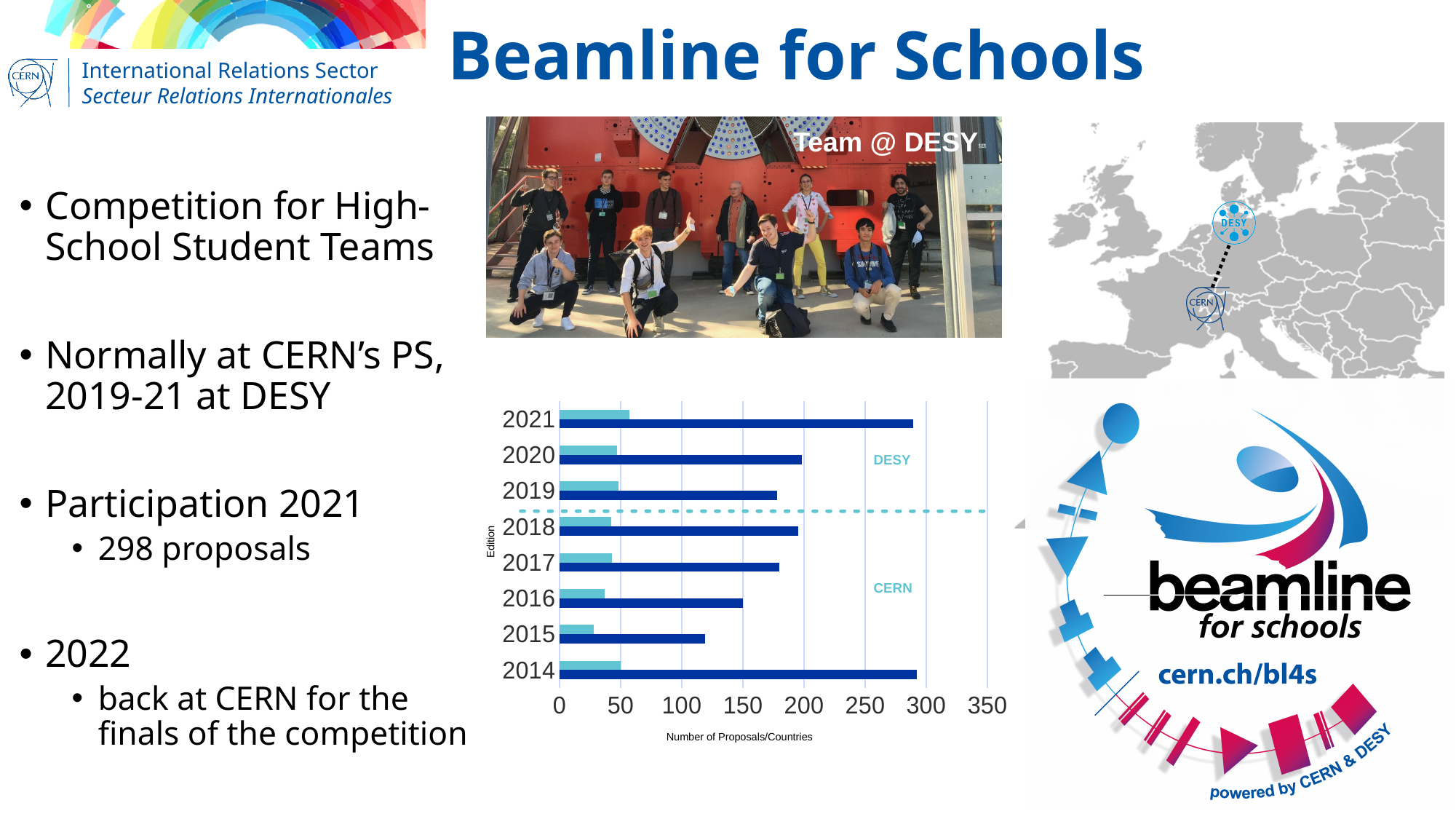
Is the dark blue bar for 2017 greater or less than 150? greater Which edition has the longer dark blue bar, 2019 or 2020? 2020 What kind of chart is shown on the slide? bar chart Which edition has the shortest dark blue bar in the chart? 2015 What is the label of the y axis of the chart? Edition Which edition has the shortest light blue bar in the chart? 2015 Is the dark blue bar for 2015 greater or less than 150? less Is the dark blue bar for 2021 greater or less than 250? greater Which edition has the longer dark blue bar, 2015 or 2016? 2016 What is the label of the x axis of the chart? Number of Proposals/Countries How many editions (categories) are shown on the y axis of the chart? 8